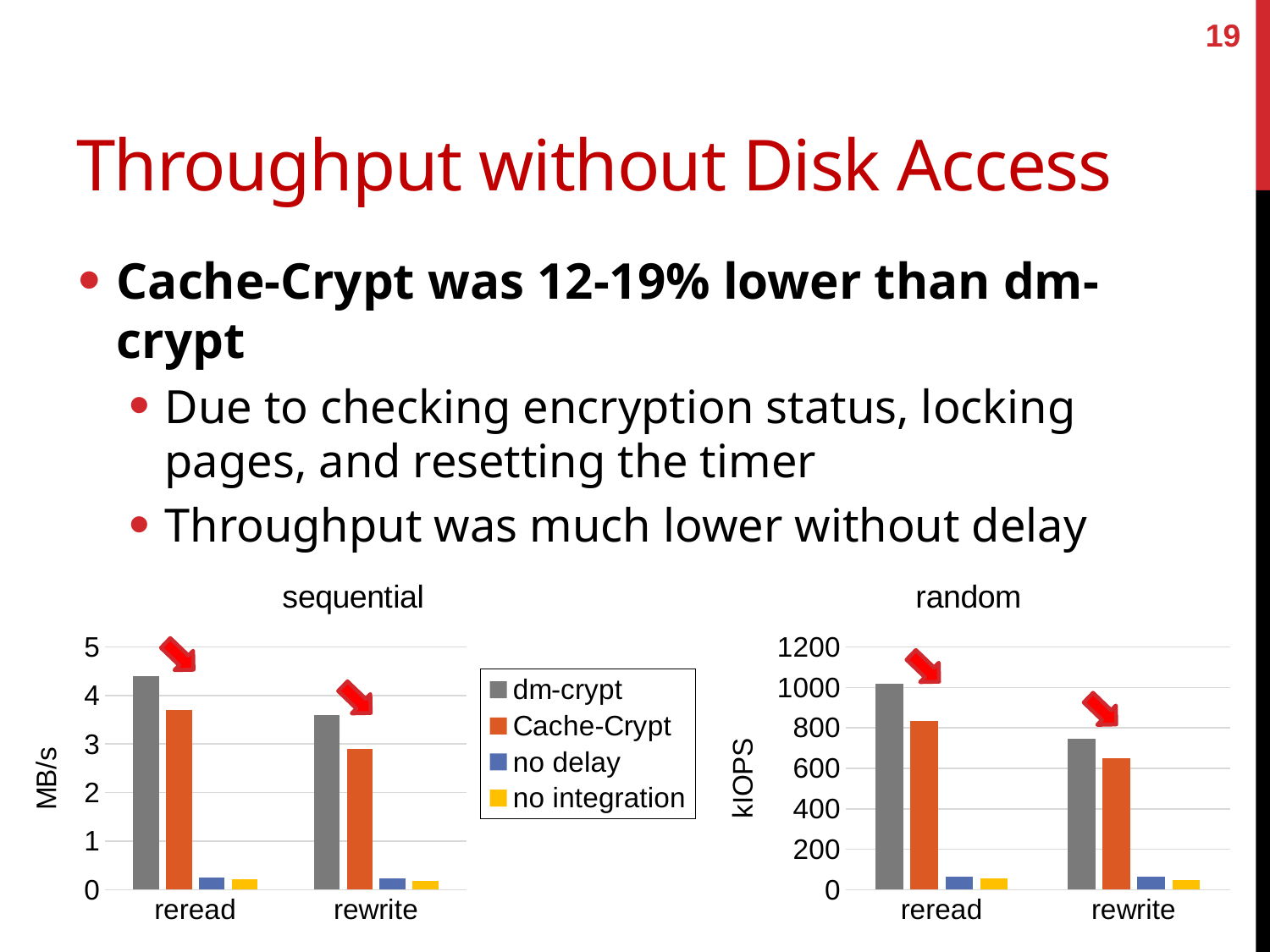
In the "sequential" chart, is the Cache-Crypt value for reread greater or less than 3? greater What kind of chart is the "sequential" chart? bar chart In the "sequential" chart, is the no delay value for rewrite greater or less than 1? less In the "random" chart, does the dm-crypt value rise or fall from reread to rewrite? fall In the "random" chart, is the dm-crypt value for rewrite greater or less than 800? less How many series does the legend list? 4 In the "sequential" chart, which series has the highest bar for reread? dm-crypt In the "random" chart, which is larger for rewrite: dm-crypt or Cache-Crypt? dm-crypt How many categories are on the x axis of the "random" chart? 2 What is the y-axis label of the "random" chart? kIOPS